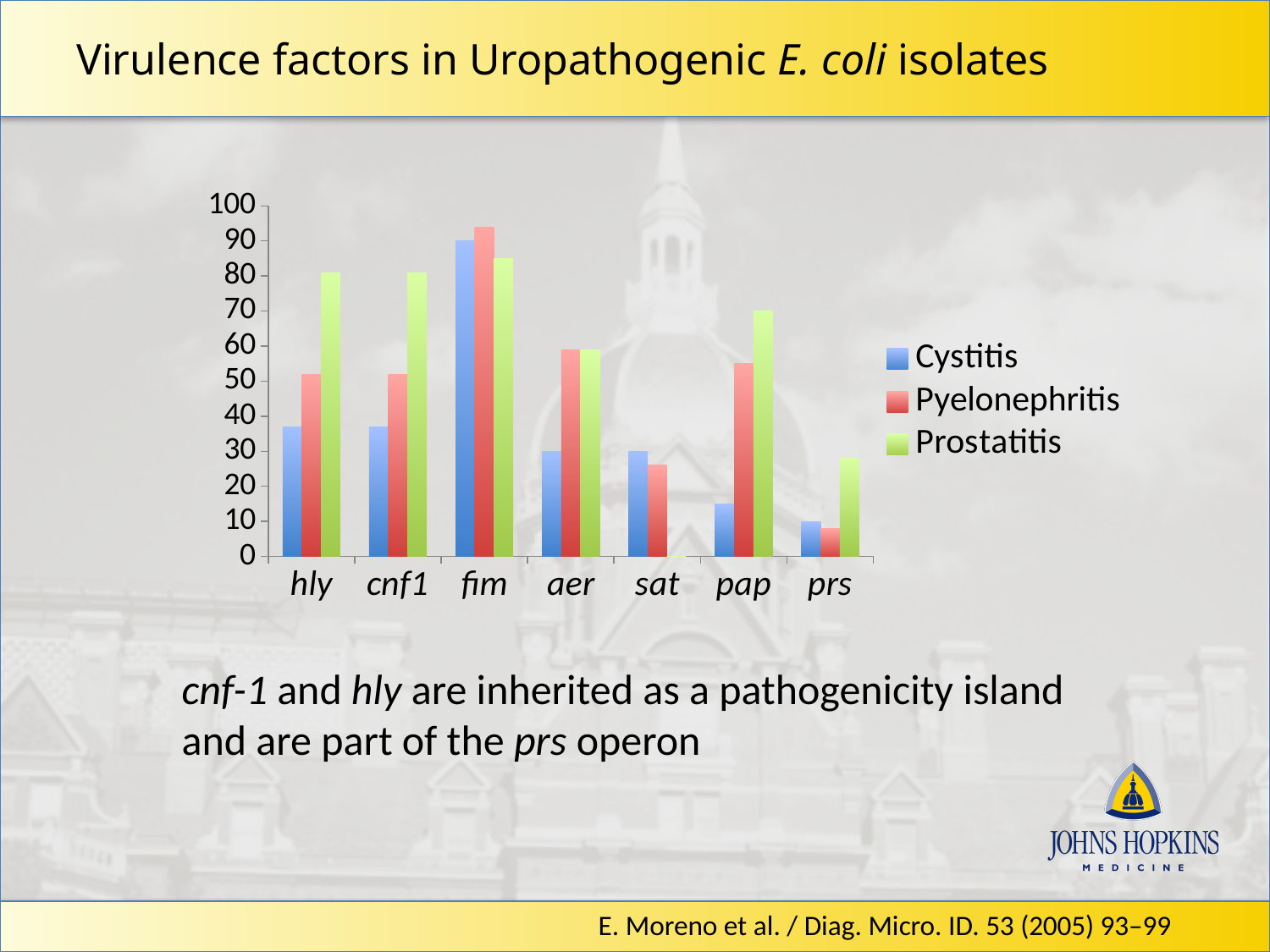
How many virulence factor categories are shown on the x axis? 7 Which category has the lowest Pyelonephritis value? prs What colour represents the Prostatitis series in the legend? green Which category has the lowest Cystitis value? prs Is the Pyelonephritis value for aer greater or less than 50? greater Which category has the highest Pyelonephritis value? fim For pap, which is larger: the Prostatitis value or the Cystitis value? Prostatitis Is the Cystitis value for pap greater or less than 20? less How many series does the legend list? 3 Which category has the highest Cystitis value? fim What kind of chart is shown on the slide? bar chart Is the Prostatitis value for hly greater or less than 70? greater